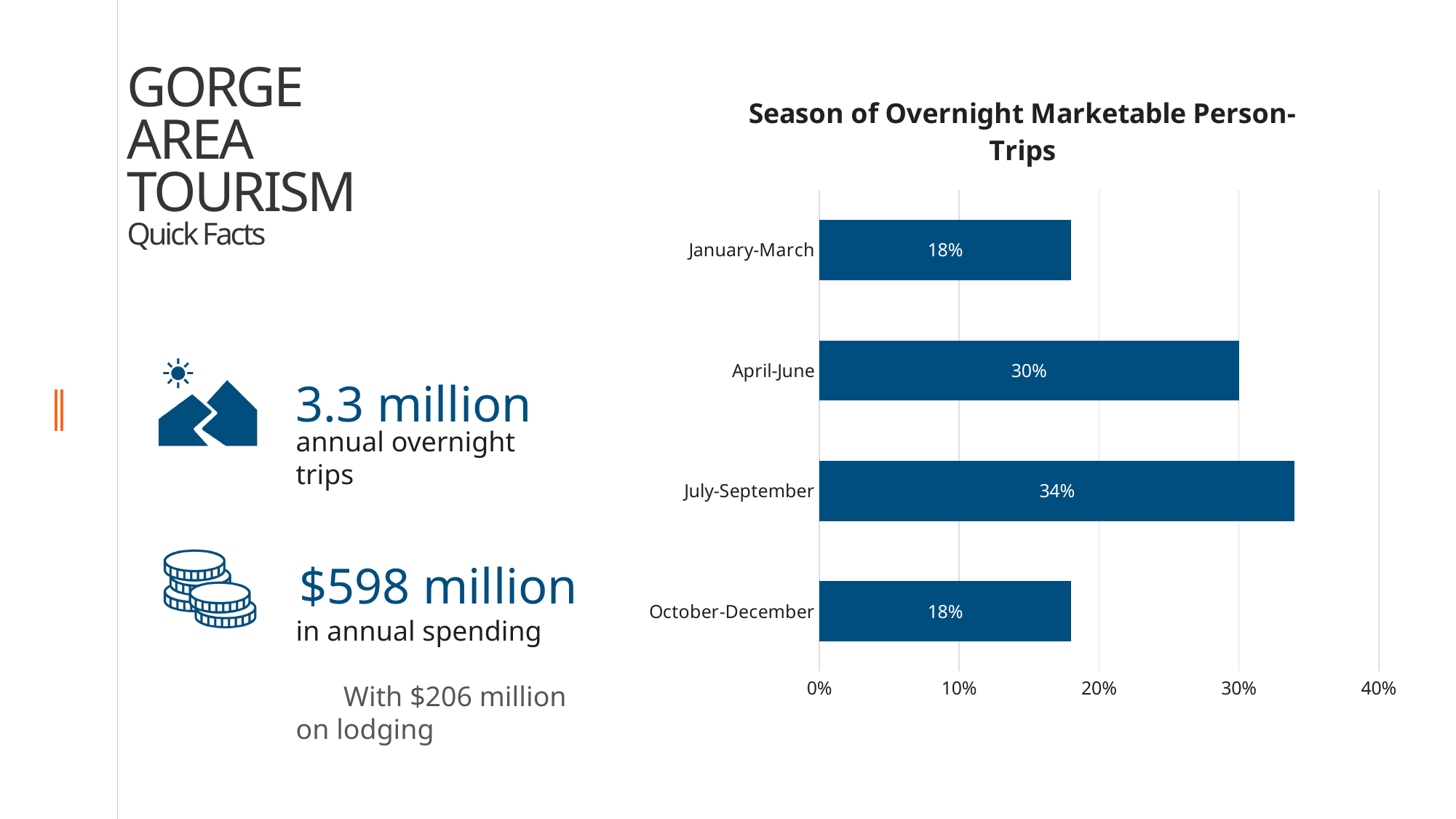
What is the value for January-March? 18% What is the title of the chart? Season of Overnight Marketable Person-Trips What kind of chart is shown on the slide? Bar chart What is the difference between the values for July-September and April-June? 4% What is the value for April-June? 30% Which season has the highest share of overnight marketable person-trips? July-September How many seasons are shown in the chart? 4 What is the difference between the values for April-June and October-December? 12% Which is larger, the value for April-June or the value for January-March? April-June What is the value for July-September? 34% Is the value for July-September greater or less than 30%? greater Is the value for October-December greater or less than 20%? less